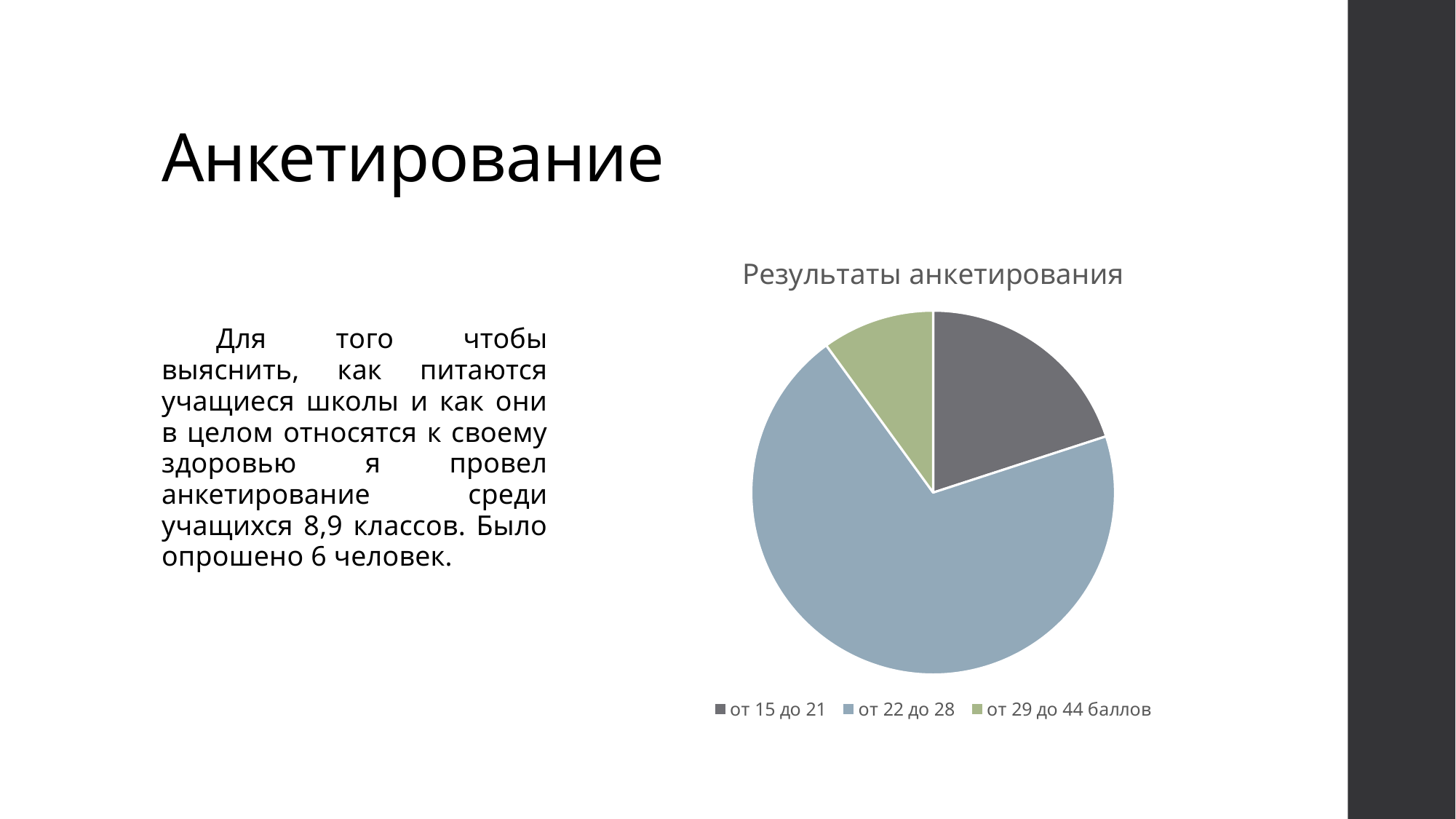
Which category has the largest slice of the pie? от 22 до 28 What is the title of the chart? Результаты анкетирования How many slices does the pie chart have? 3 Which category has the smallest slice of the pie? от 29 до 44 баллов Which slice is larger: "от 15 до 21" or "от 29 до 44 баллов"? от 15 до 21 Which category is shown in green in the pie chart? от 29 до 44 баллов What kind of chart is shown on the slide? Pie chart Does the slice for "от 22 до 28" take up more or less than half of the pie? more How many entries does the chart legend list? 3 Which slice is larger: "от 22 до 28" or "от 15 до 21"? от 22 до 28